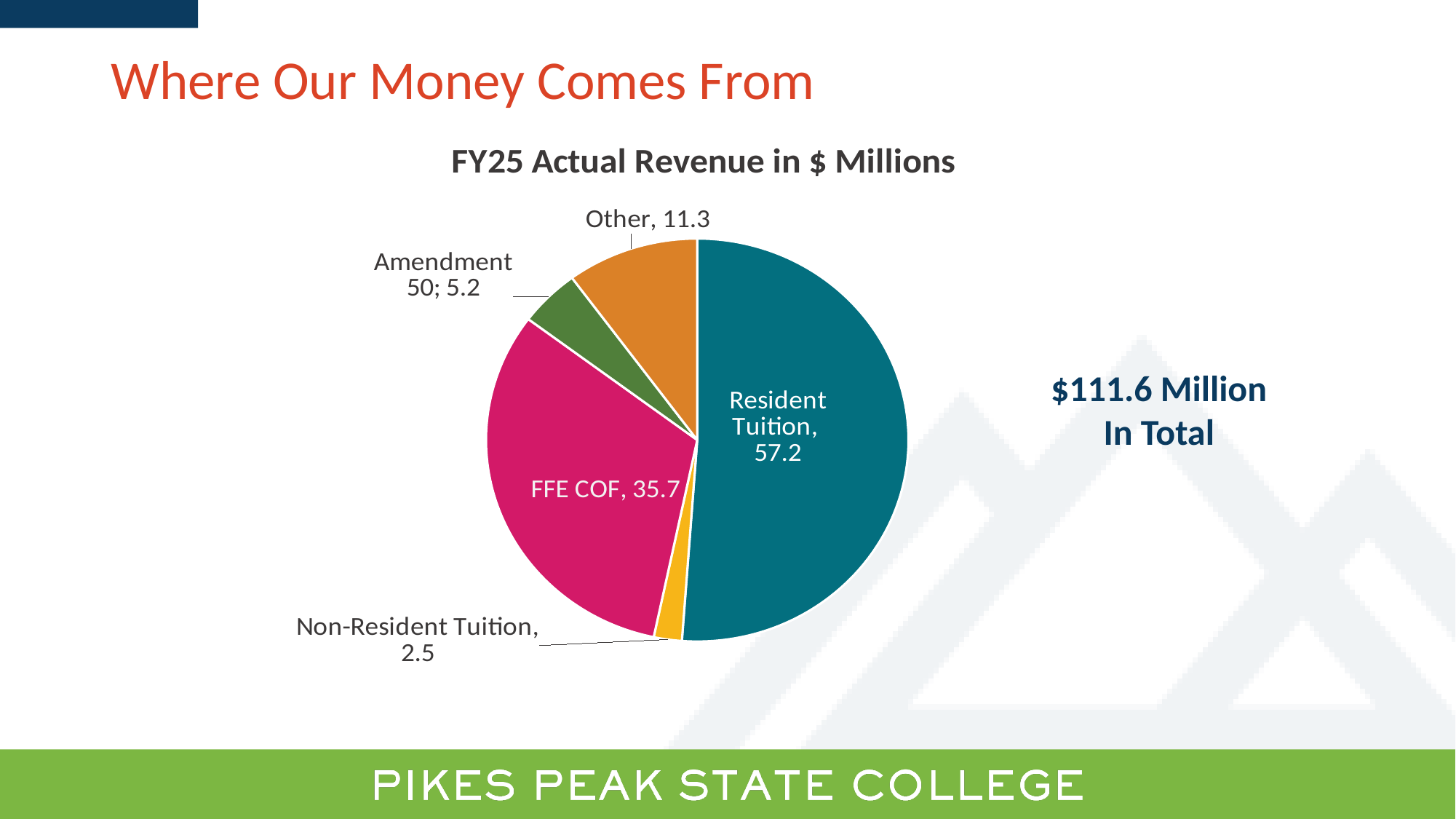
Which category has the largest slice of the pie chart? Resident Tuition What kind of chart is shown on the slide? Pie chart What is the difference between Resident Tuition and FFE COF? 21.5 What is the difference between Other and Amendment 50? 6.1 What is the value for FFE COF in the pie chart? 35.7 How many categories are shown in the pie chart? 5 Which category has the smallest slice of the pie chart? Non-Resident Tuition What is the value for Amendment 50 in the pie chart? 5.2 What is the value for Resident Tuition in the pie chart? 57.2 What is the value for Non-Resident Tuition in the pie chart? 2.5 Which is larger, Other or Amendment 50? Other What is the title of the chart? FY25 Actual Revenue in $ Millions